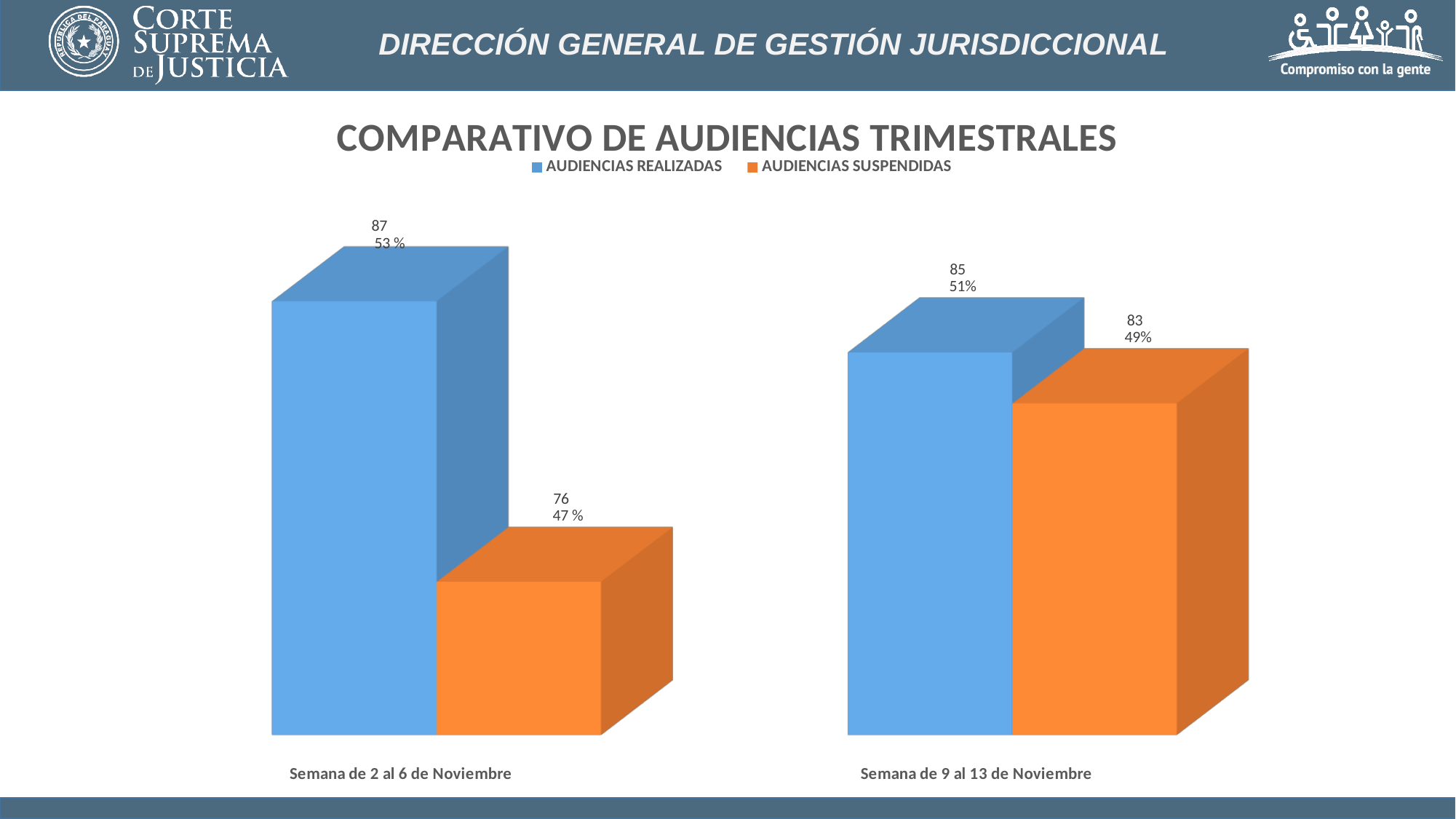
What is the value of AUDIENCIAS REALIZADAS for Semana de 2 al 6 de Noviembre? 87 What is the value of AUDIENCIAS SUSPENDIDAS for Semana de 9 al 13 de Noviembre? 83 What is the title of the chart? COMPARATIVO DE AUDIENCIAS TRIMESTRALES What is the value of AUDIENCIAS SUSPENDIDAS for Semana de 2 al 6 de Noviembre? 76 Which week has the higher value for AUDIENCIAS REALIZADAS? Semana de 2 al 6 de Noviembre How many series does the legend list? 2 What is the value of AUDIENCIAS REALIZADAS for Semana de 9 al 13 de Noviembre? 85 Which is larger for Semana de 9 al 13 de Noviembre: AUDIENCIAS REALIZADAS or AUDIENCIAS SUSPENDIDAS? AUDIENCIAS REALIZADAS What kind of chart is shown on the slide? Bar chart What percentage is shown for AUDIENCIAS SUSPENDIDAS in Semana de 9 al 13 de Noviembre? 49% Which week has the lower value for AUDIENCIAS SUSPENDIDAS? Semana de 2 al 6 de Noviembre What is the difference between AUDIENCIAS REALIZADAS and AUDIENCIAS SUSPENDIDAS for Semana de 2 al 6 de Noviembre? 11